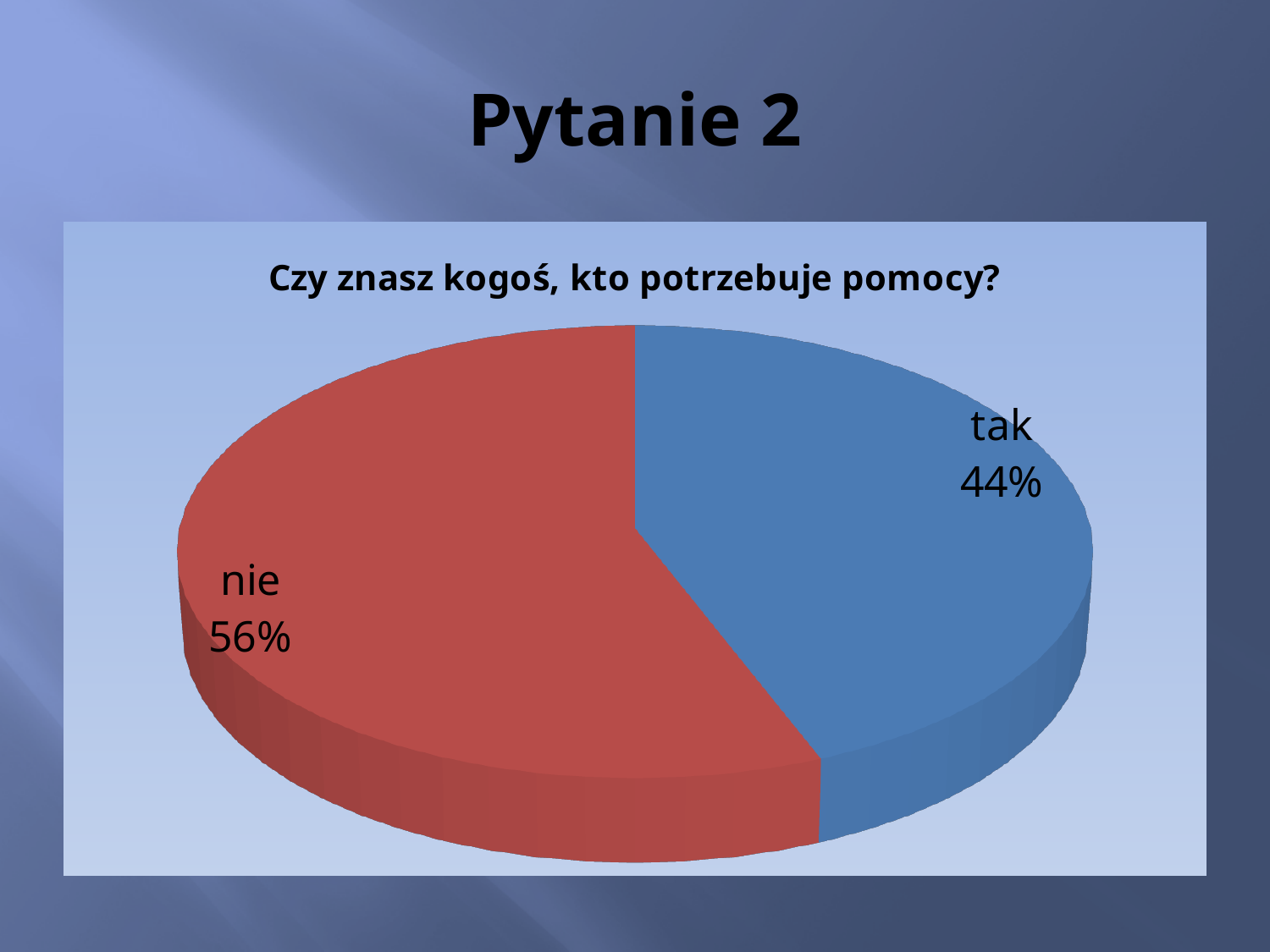
What share of the pie does "nie" represent? 56% What share of the pie does "tak" represent? 44% Which category has the largest slice of the pie? nie What is the difference in percentage points between "nie" and "tak"? 12 percentage points What kind of chart is shown on the slide? pie chart Which is larger, the share for "tak" or the share for "nie"? nie What is the title of the chart? Czy znasz kogoś, kto potrzebuje pomocy? Is the share for "tak" greater or less than 50%? less What colour is the "nie" slice? red Which category has the smallest slice of the pie? tak How many categories are shown in the pie chart? 2